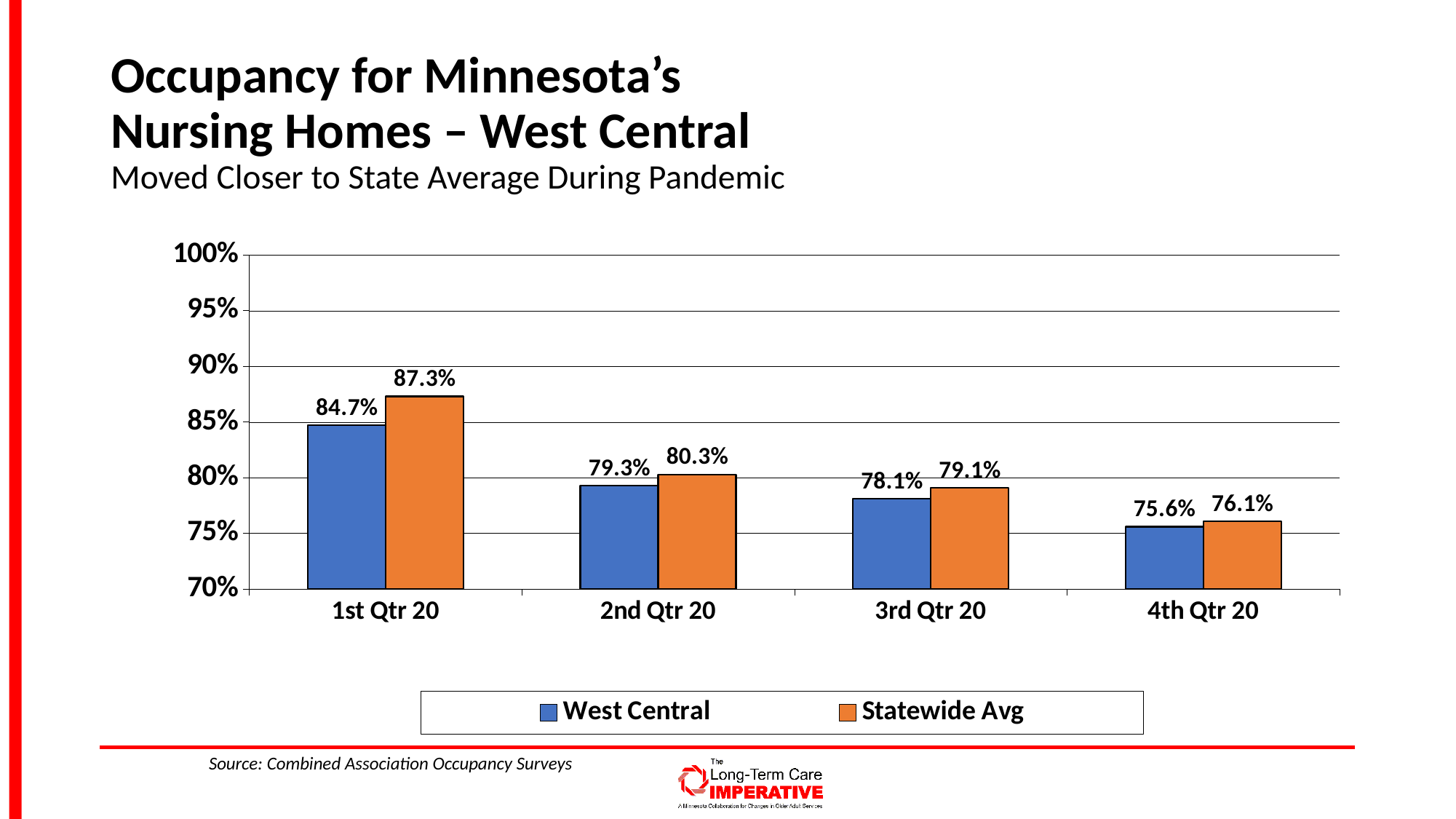
What kind of chart is shown on the slide? Bar chart How many quarters are shown on the x axis? 4 What is the Statewide Avg occupancy value for 4th Qtr 20? 76.1% How many series does the legend list? 2 Do the West Central values rise or fall from 1st Qtr 20 to 4th Qtr 20? Fall What is the difference between the Statewide Avg and West Central values in 4th Qtr 20? 0.5% What is the West Central occupancy value for 1st Qtr 20? 84.7% What is the difference between the Statewide Avg and West Central values in 1st Qtr 20? 2.6% In which quarter is the West Central occupancy highest? 1st Qtr 20 What is the Statewide Avg value for 2nd Qtr 20? 80.3% Which is larger in 3rd Qtr 20, West Central or Statewide Avg? Statewide Avg In which quarter is the Statewide Avg occupancy lowest? 4th Qtr 20